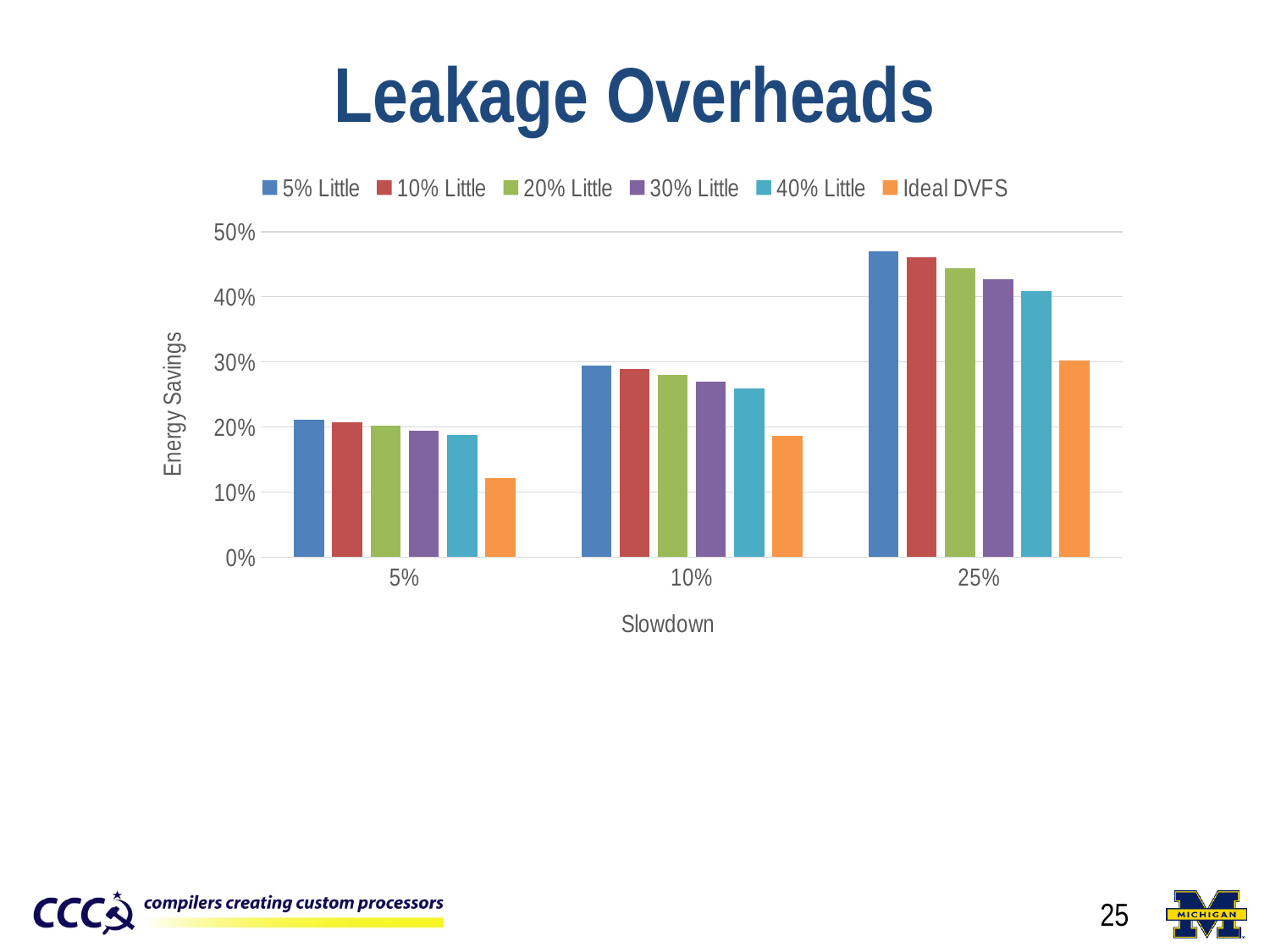
What kind of chart is shown on the slide? bar chart Which series has the lowest energy savings at 25% slowdown? Ideal DVFS Is the energy savings for 40% Little at 10% slowdown greater or less than 20%? greater Is the energy savings for Ideal DVFS at 5% slowdown greater or less than 20%? less What is the title of the chart on the slide? Leakage Overheads How many slowdown categories are shown on the x axis? 3 Do the energy savings for each series rise or fall as slowdown increases along the x axis? rise Which series has the lowest energy savings at 5% slowdown? Ideal DVFS Is the energy savings for 5% Little at 25% slowdown greater or less than 40%? greater How many series does the legend list? 6 Which is larger: the energy savings for 5% Little at 25% slowdown or at 5% slowdown? 25% slowdown